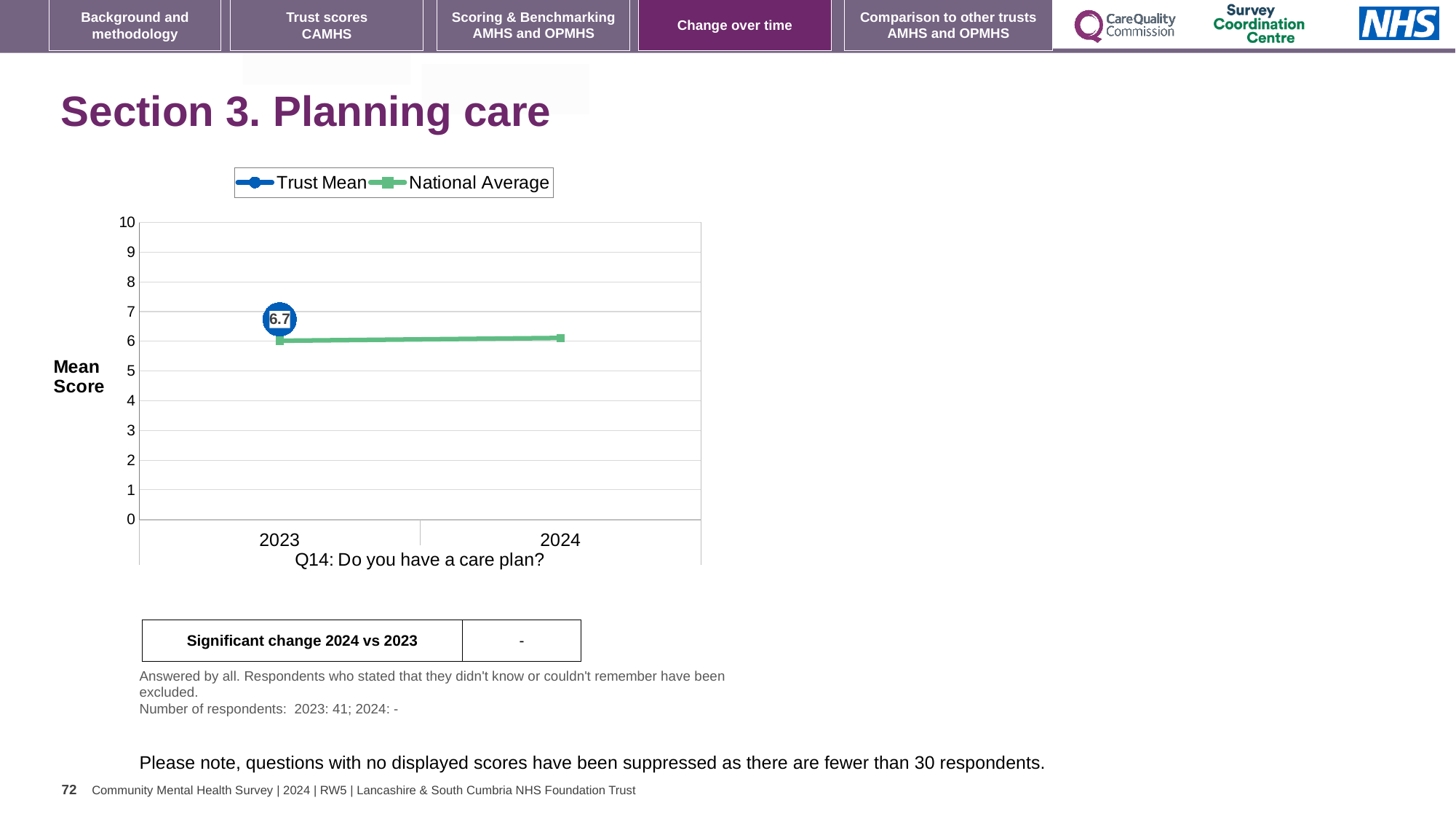
Is the Trust Mean for 2023 greater or less than 6? greater How many series does the legend list? 2 Is the National Average for 2024 greater or less than 5? greater Which series is shown in green in the legend? National Average How many years are shown on the x axis? 2 Is the National Average for 2023 greater or less than 7? less What is the label on the y axis of the chart? Mean Score What is the Trust Mean score for 2023? 6.7 In 2023, which is larger: the Trust Mean or the National Average? Trust Mean What kind of chart is shown on the slide? Line chart